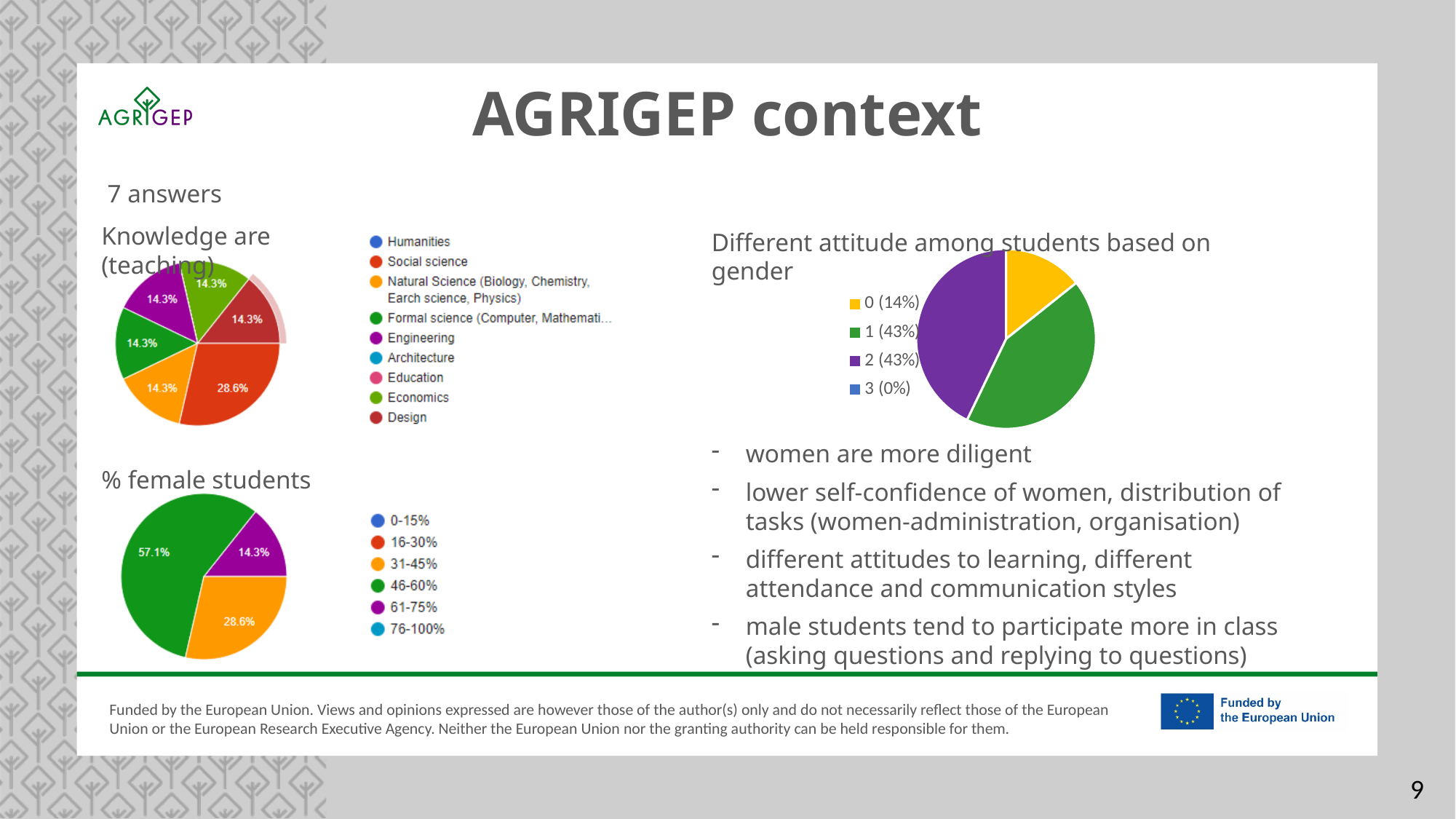
In the 'Knowledge are (teaching)' pie chart, what share does Social science have? 28.6% In the 'Knowledge are (teaching)' pie chart, what is the difference between the Social science share and the Engineering share? 14.3% In the '% female students' pie chart, what share does the 31-45% category have? 28.6% How many entries does the legend of the 'Knowledge are (teaching)' pie chart list? 9 In the '% female students' pie chart, which category has the smallest non-zero slice? 61-75% In the '% female students' pie chart, what share does the 46-60% category have? 57.1% How many entries does the legend of the 'Different attitude among students based on gender' pie chart list? 4 In the 'Different attitude among students based on gender' pie chart, what share does category 3 have? 0% In the 'Different attitude among students based on gender' pie chart, what share does category 1 have? 43% What type of chart is used for '% female students'? Pie chart In the '% female students' pie chart, which is larger: the 46-60% slice or the 31-45% slice? 46-60% In the 'Knowledge are (teaching)' pie chart, which category has the largest slice? Social science